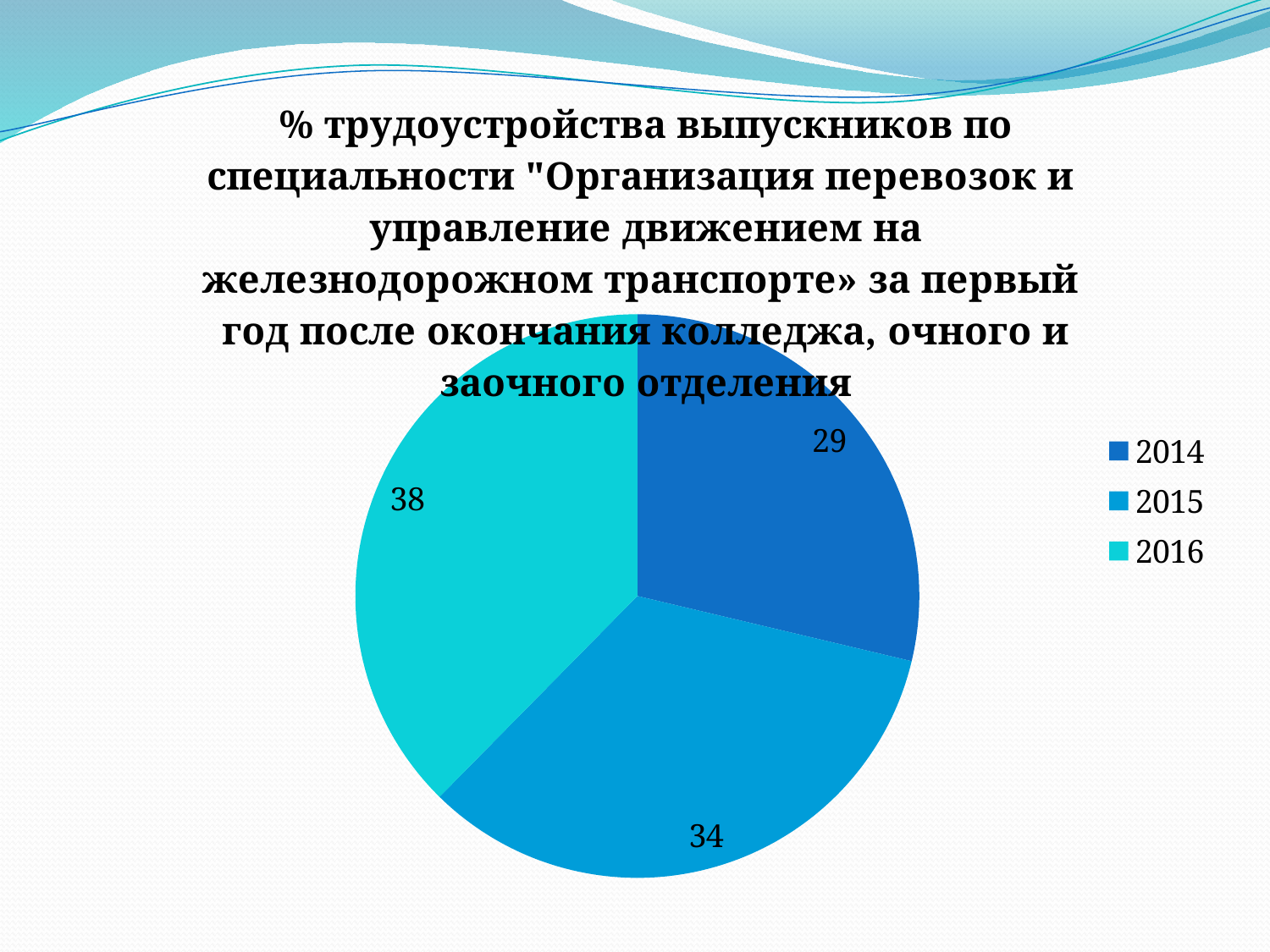
What is the value for 2014 in the pie chart? 29 How many slices does the pie chart have? 3 Which is larger, the value for 2015 or the value for 2016? 2016 What kind of chart is shown on the slide? pie chart Which year has the smallest slice in the pie chart? 2014 What is the value for 2016 in the pie chart? 38 How many entries does the legend list? 3 What is the value for 2015 in the pie chart? 34 Which year has the largest slice in the pie chart? 2016 What is the difference between the values for 2016 and 2014? 9 Do the values increase or decrease from 2014 to 2016? increase What is the difference between the values for 2015 and 2014? 5